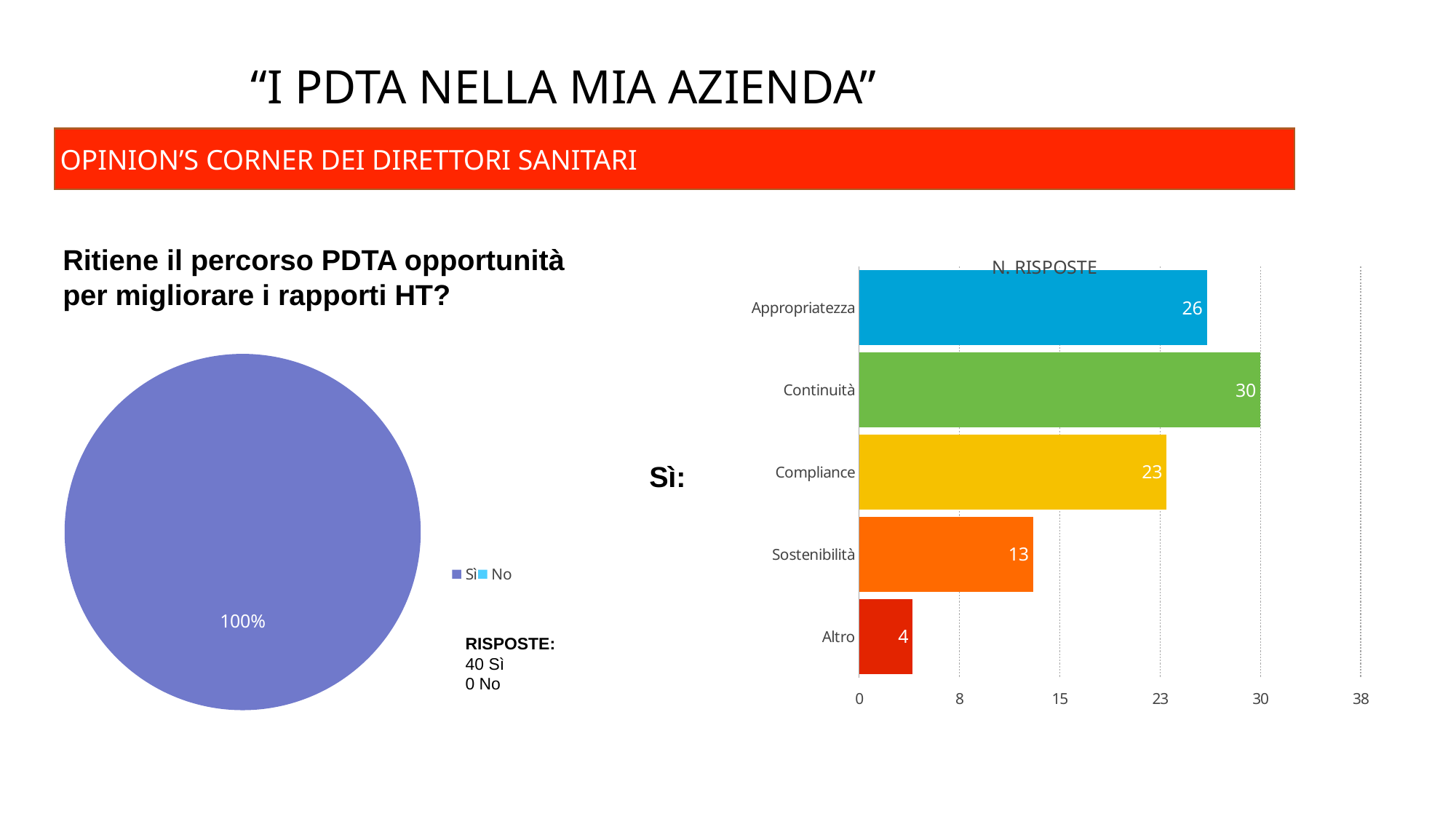
In the bar chart titled "N. RISPOSTE", how many categories are shown? 5 How many entries does the legend of the pie chart on the left list? 2 In the bar chart titled "N. RISPOSTE", which category has the highest value? Continuità In the bar chart titled "N. RISPOSTE", which is larger, the value for Compliance or the value for Sostenibilità? Compliance In the bar chart titled "N. RISPOSTE", what is the value for Sostenibilità? 13 What kind of chart is the chart on the right of the slide? bar chart In the pie chart on the left, what share is shown for Sì? 100% In the bar chart titled "N. RISPOSTE", which category has the lowest value? Altro In the bar chart titled "N. RISPOSTE", what colour is the bar for Compliance? yellow In the bar chart titled "N. RISPOSTE", what is the value for Continuità? 30 In the bar chart titled "N. RISPOSTE", what is the difference between the values for Appropriatezza and Compliance? 3 What kind of chart is the chart on the left of the slide? pie chart